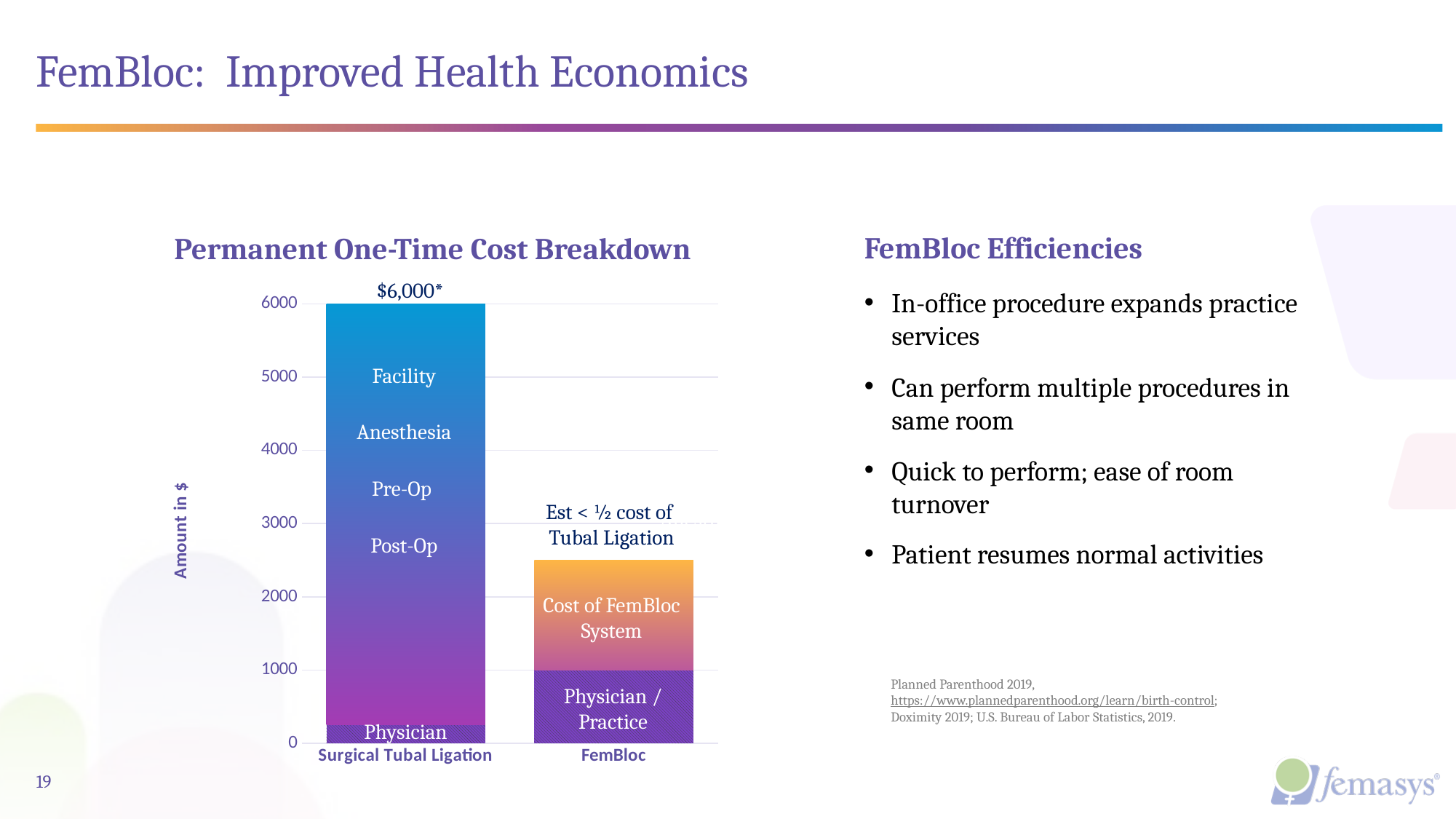
Which category has the lowest total cost in the chart? FemBloc Is the total value for FemBloc greater or less than 2000? greater Is the Physician segment of the Surgical Tubal Ligation bar greater or less than 1000? less What is the y-axis label of the cost breakdown chart? Amount in $ What type of chart is shown under "Permanent One-Time Cost Breakdown"? Stacked bar chart What text annotation is shown above the FemBloc bar? Est < ½ cost of Tubal Ligation Is the Physician / Practice segment of the FemBloc bar greater or less than 2000? less How many categories are shown on the x axis of the cost breakdown chart? 2 Which segment sits at the top of the FemBloc bar? Cost of FemBloc System Which category has the higher total cost, Surgical Tubal Ligation or FemBloc? Surgical Tubal Ligation What is the total one-time cost shown for Surgical Tubal Ligation? $6,000*